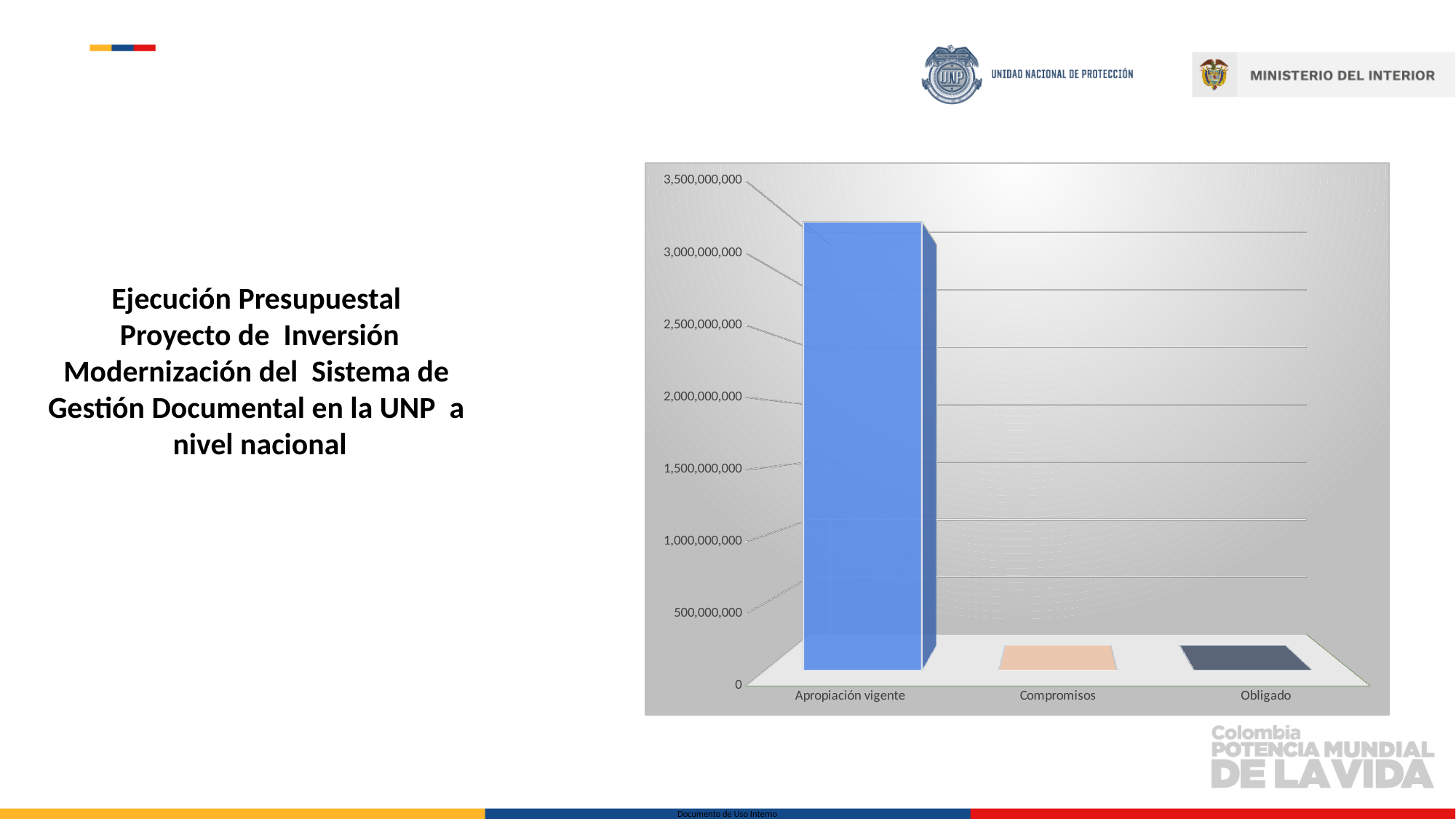
Which is larger, the value for Obligado or the value for Apropiación vigente? Apropiación vigente What is the highest value shown on the vertical axis of the chart? 3,500,000,000 How many categories are shown on the x axis of the chart? 3 Which is larger, the value for Apropiación vigente or the value for Compromisos? Apropiación vigente Is the value for Compromisos greater or less than 500,000,000? less Is the value for Apropiación vigente greater or less than 3,500,000,000? less Is the value for Apropiación vigente greater or less than 3,000,000,000? greater Which category has the highest value in the chart? Apropiación vigente What kind of chart is shown on the slide? bar chart What colour is the bar for Apropiación vigente? blue